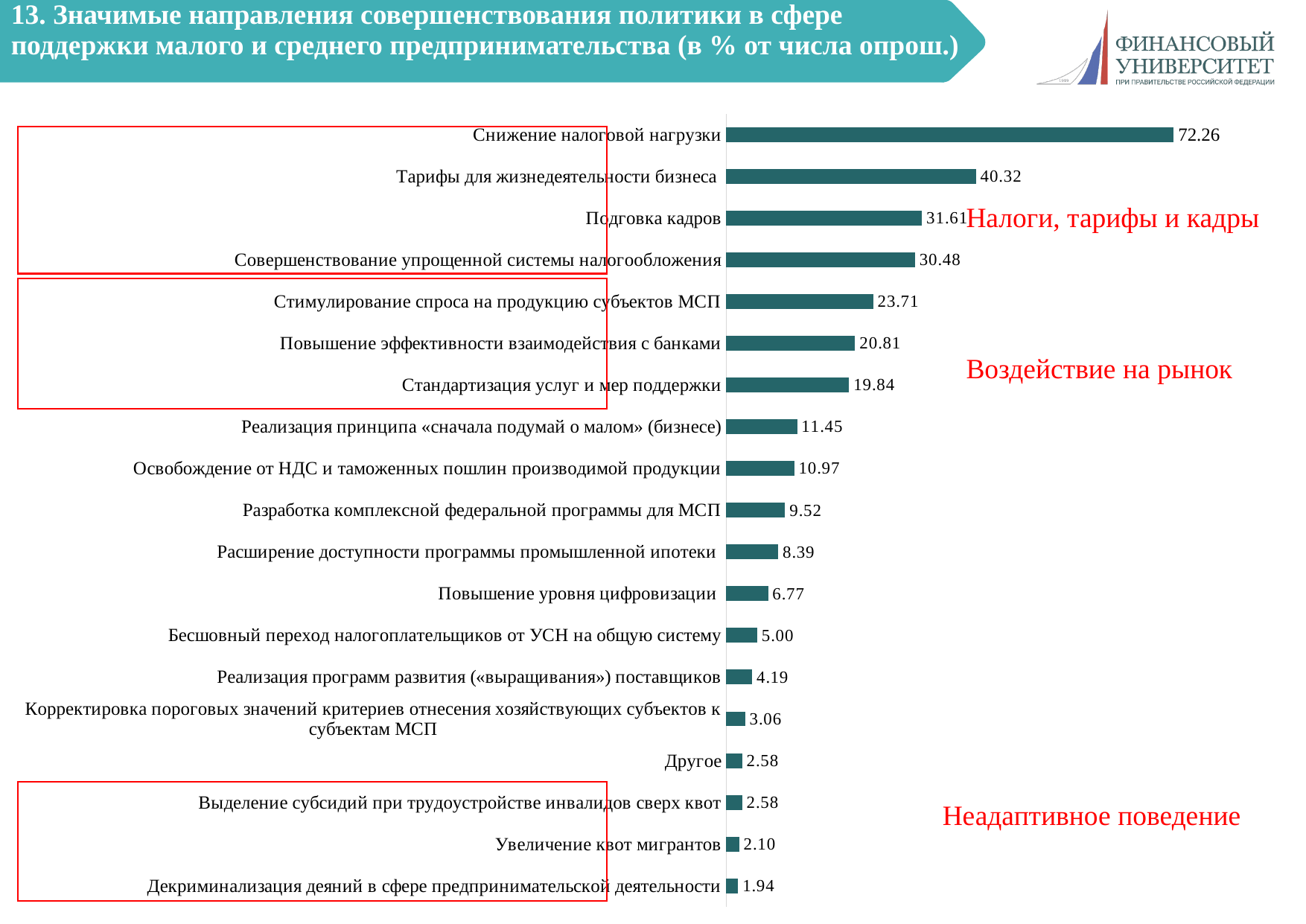
Which is larger: the value for «Стимулирование спроса на продукцию субъектов МСП» or for «Стандартизация услуг и мер поддержки»? Стимулирование спроса на продукцию субъектов МСП What is the difference between the values for «Снижение налоговой нагрузки» and «Тарифы для жизнедеятельности бизнеса»? 31.94 What is the difference between the values for «Подговка кадров» and «Совершенствование упрощенной системы налогообложения»? 1.13 What value is shown for «Снижение налоговой нагрузки»? 72.26 What type of chart is shown on the slide? Bar chart What value is shown for «Тарифы для жизнедеятельности бизнеса»? 40.32 What red annotation is placed next to the bottom group of bars? Неадаптивное поведение What value is shown for «Увеличение квот мигрантов»? 2.10 What value is shown for «Повышение уровня цифровизации»? 6.77 Which category has the highest value? Снижение налоговой нагрузки Which category has the lowest value? Декриминализация деяний в сфере предпринимательской деятельности How many categories are plotted in the chart? 19